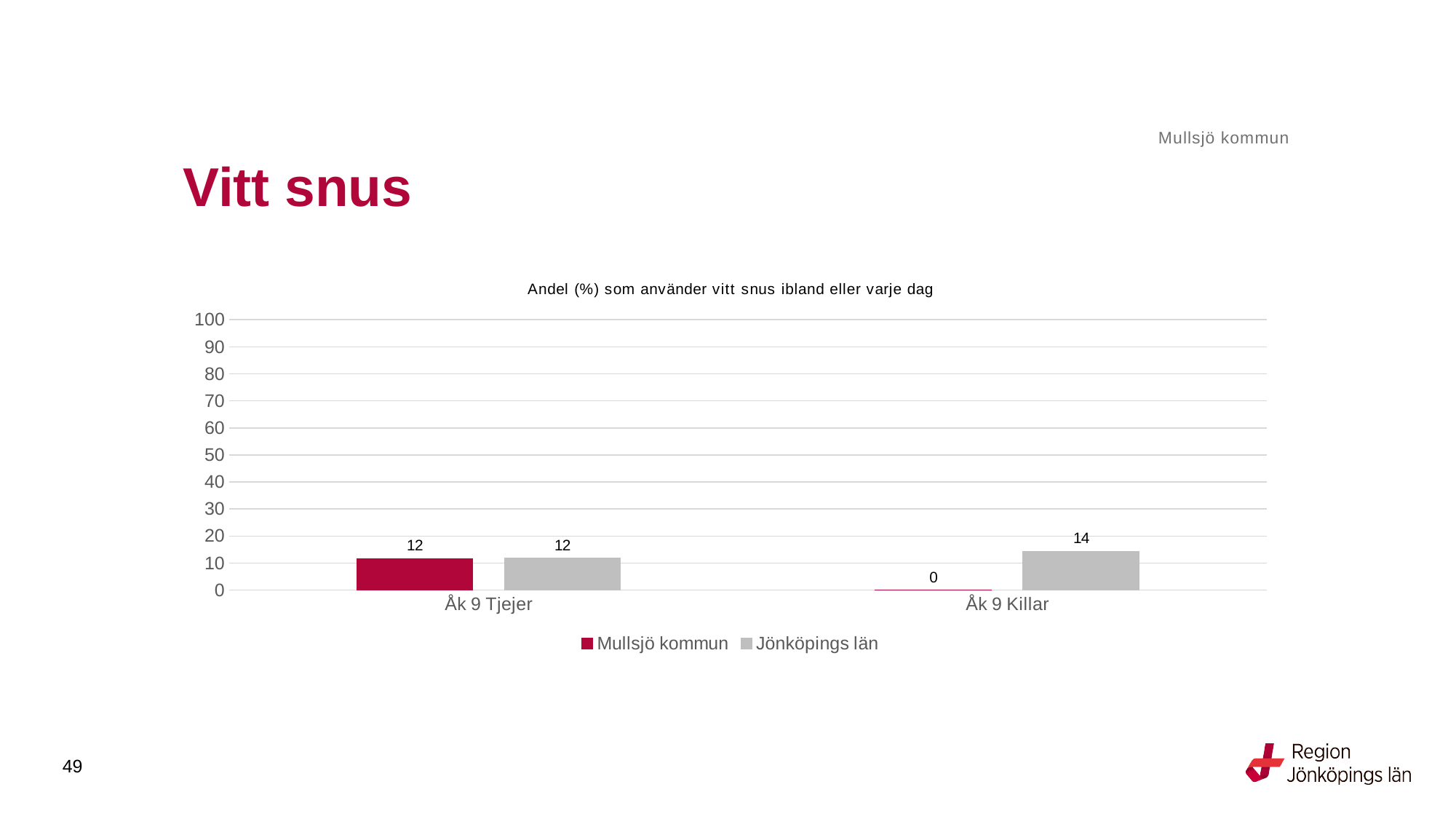
What is the value for Mullsjö kommun in the Åk 9 Tjejer category? 12 How many series does the legend list? 2 What is the value for Jönköpings län in the Åk 9 Tjejer category? 12 What is the difference between Jönköpings län and Mullsjö kommun in the Åk 9 Killar category? 14 How many categories are shown on the x axis? 2 Which category has the highest value for Jönköpings län? Åk 9 Killar Which is larger in the Åk 9 Killar category: Mullsjö kommun or Jönköpings län? Jönköpings län What is the value for Jönköpings län in the Åk 9 Killar category? 14 What is the value for Mullsjö kommun in the Åk 9 Killar category? 0 Is the value for Jönköpings län in Åk 9 Killar greater or less than 20? less What kind of chart is shown on the slide? bar chart Which category has the lowest value for Mullsjö kommun? Åk 9 Killar